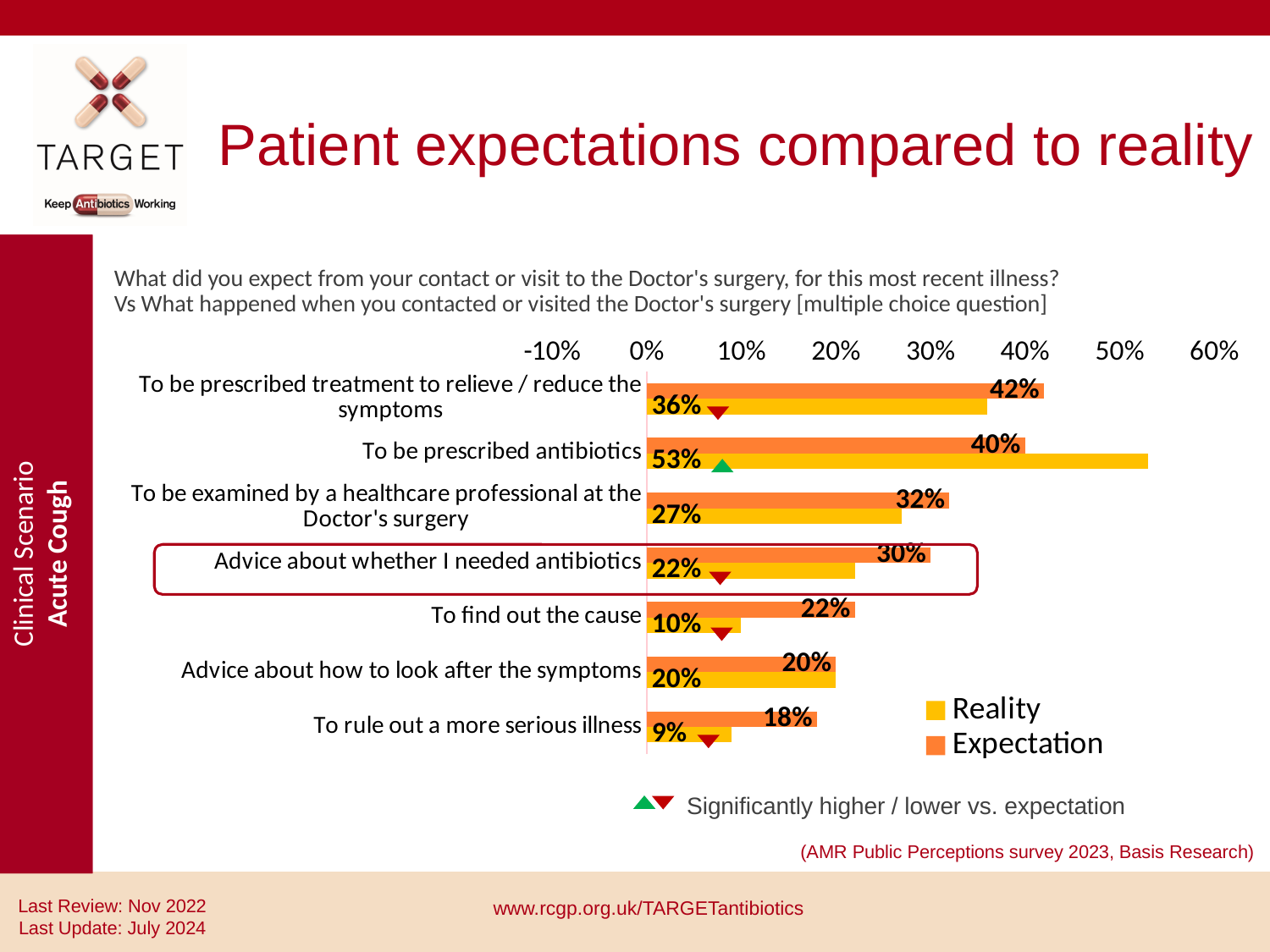
Which category has the highest Reality value? To be prescribed antibiotics Which series is shown in yellow in the legend? Reality How many categories are plotted in the chart? 7 What is the difference between the Expectation and Reality values for "To find out the cause"? 12% What is the Reality value for "To rule out a more serious illness"? 9% What is the Expectation value for "To be prescribed antibiotics"? 40% What is the Reality value for "To be prescribed antibiotics"? 53% What type of chart is shown on the slide? bar chart How many series does the legend list? 2 Which category has the lowest Expectation value? To rule out a more serious illness What is the Expectation value for "Advice about whether I needed antibiotics"? 30% Which is larger for "To be prescribed treatment to relieve / reduce the symptoms": the Expectation value or the Reality value? Expectation